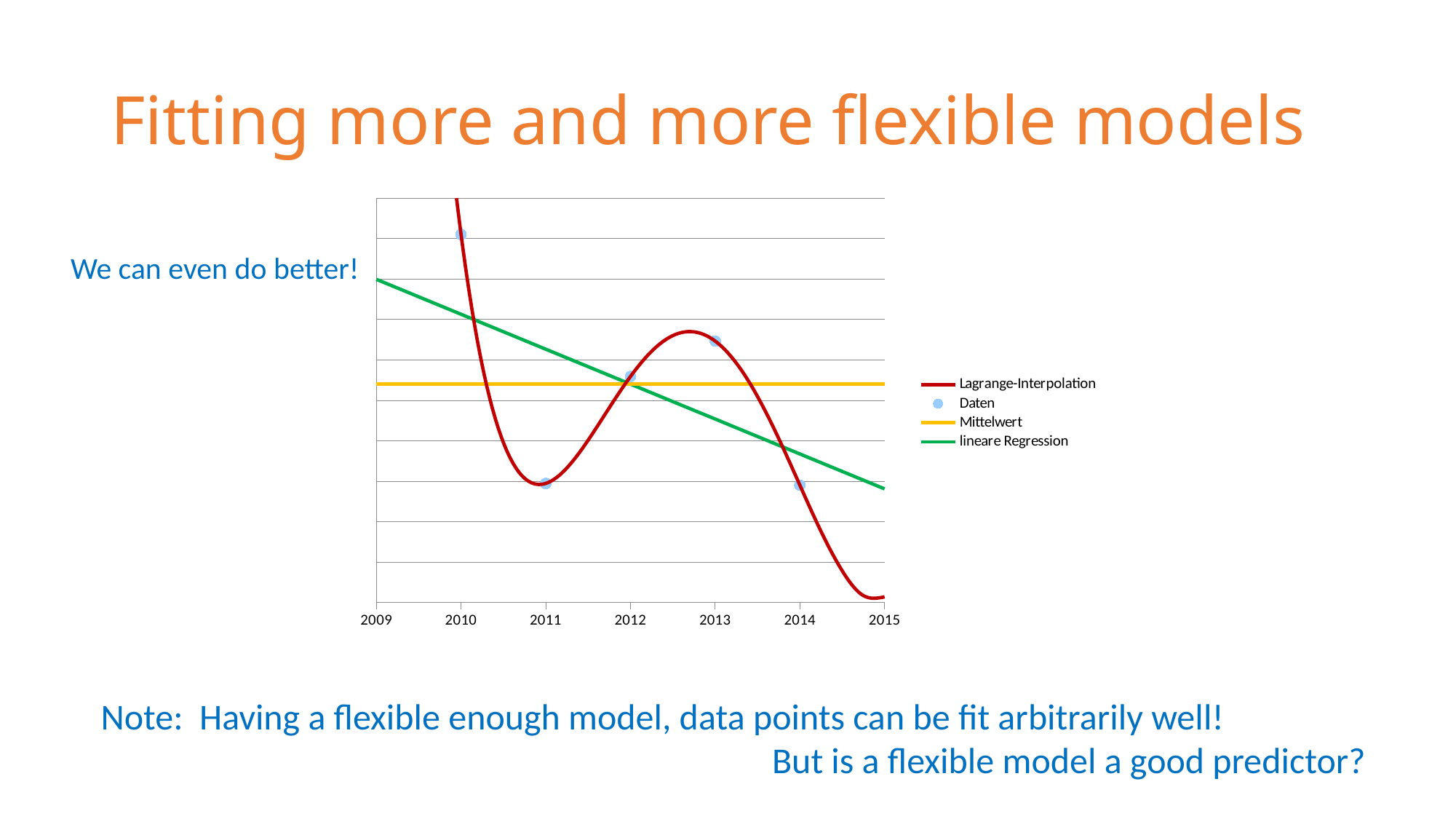
What is the last year shown on the x axis of the chart? 2015 Does the 'lineare Regression' line rise or fall from 2009 to 2015? Fall Is the data point for 2010 higher or lower than the data point for 2013? Higher Is the data point for 2013 higher or lower than the data point for 2012? Higher Which legend entry is drawn in yellow on the chart? Mittelwert Is the data point for 2011 higher or lower than the data point for 2012? Lower What kind of chart is shown on the slide? Line chart How many series does the chart legend list? 4 Which legend entry is drawn in red on the chart? Lagrange-Interpolation How many data points (Daten) are plotted on the chart? 5 What is the first year shown on the x axis of the chart? 2009 Which year has the highest data point (Daten) on the chart? 2010